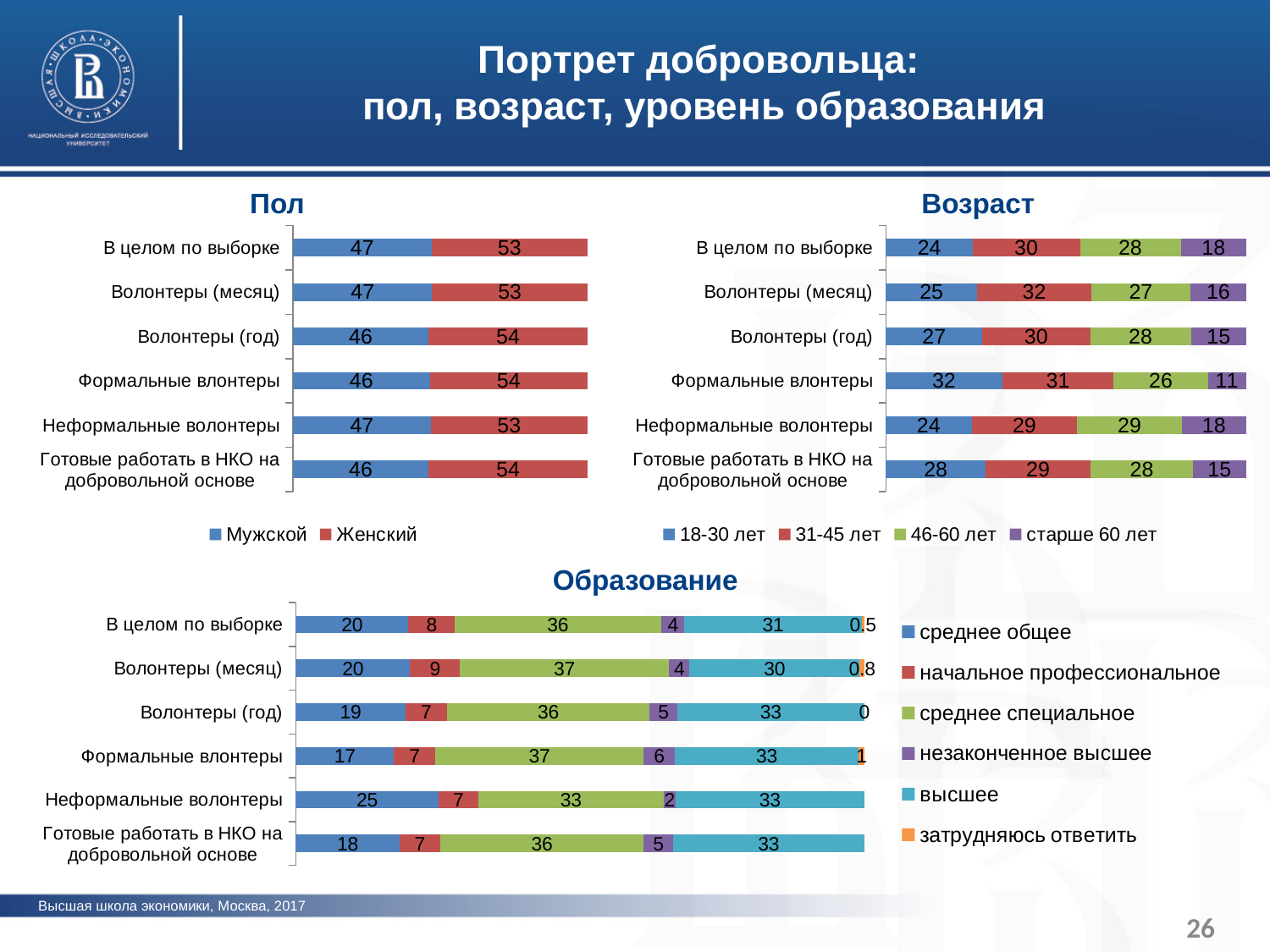
In the "Возраст" chart, what is the total of the stacked bar for В целом по выборке? 100 In the "Образование" chart, which is larger for среднее общее: Неформальные волонтеры or Формальные влонтеры? Неформальные волонтеры In the "Возраст" chart, which category has the highest value for 18-30 лет? Формальные влонтеры How many categories are shown in the "Пол" chart? 6 How many series does the legend of the "Образование" chart list? 6 In the "Пол" chart, what is the difference between Женский and Мужской for В целом по выборке? 6 In the "Возраст" chart, which category has the lowest value for старше 60 лет? Формальные влонтеры In the "Образование" chart, what is the value for высшее for Волонтеры (год)? 33 In the "Пол" chart, what is the value for Мужской for Формальные влонтеры? 46 What kind of chart is the "Возраст" chart? Stacked bar chart What are the two legend entries of the "Пол" chart? Мужской, Женский In the "Возраст" chart, what is the value for 31-45 лет for Волонтеры (месяц)? 32